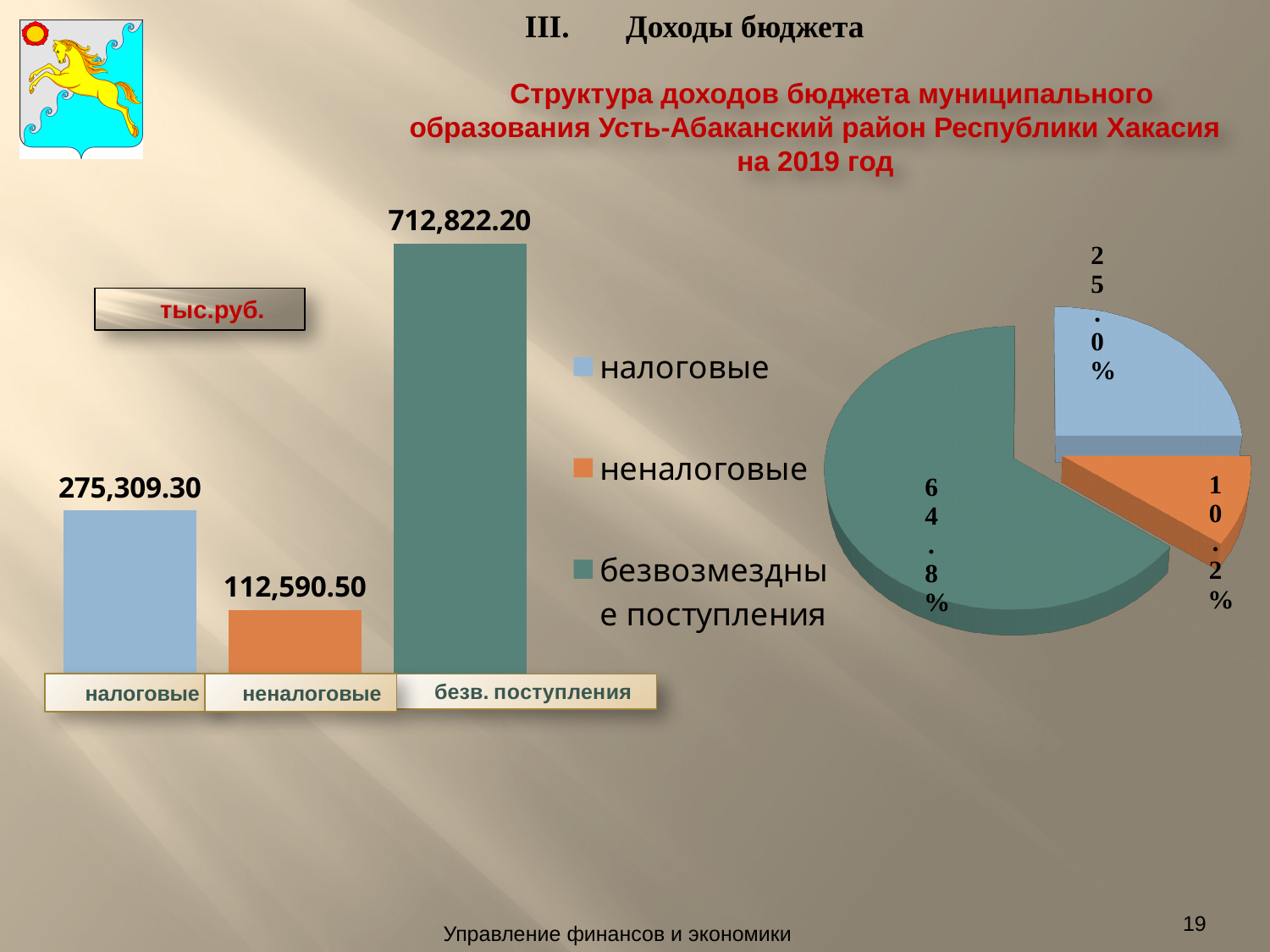
How many entries does the legend list? 3 On the pie chart on the right, what share does the налоговые slice have? 25.0% On the pie chart on the right, what share does the безвозмездные поступления slice have? 64.8% On the bar chart on the left, what is the value for налоговые? 275,309.30 What kind of chart is shown on the left of the slide? bar chart On the bar chart on the left, which category has the lowest value? неналоговые On the bar chart on the left, what is the value for неналоговые? 112,590.50 On the bar chart on the left, which is larger: налоговые or неналоговые? налоговые On the bar chart on the left, what is the difference between the values for налоговые and неналоговые? 162,718.80 How many bars are shown on the bar chart on the left? 3 On the bar chart on the left, which category has the highest value? безв. поступления On the bar chart on the left, what is the value for безв. поступления? 712,822.20